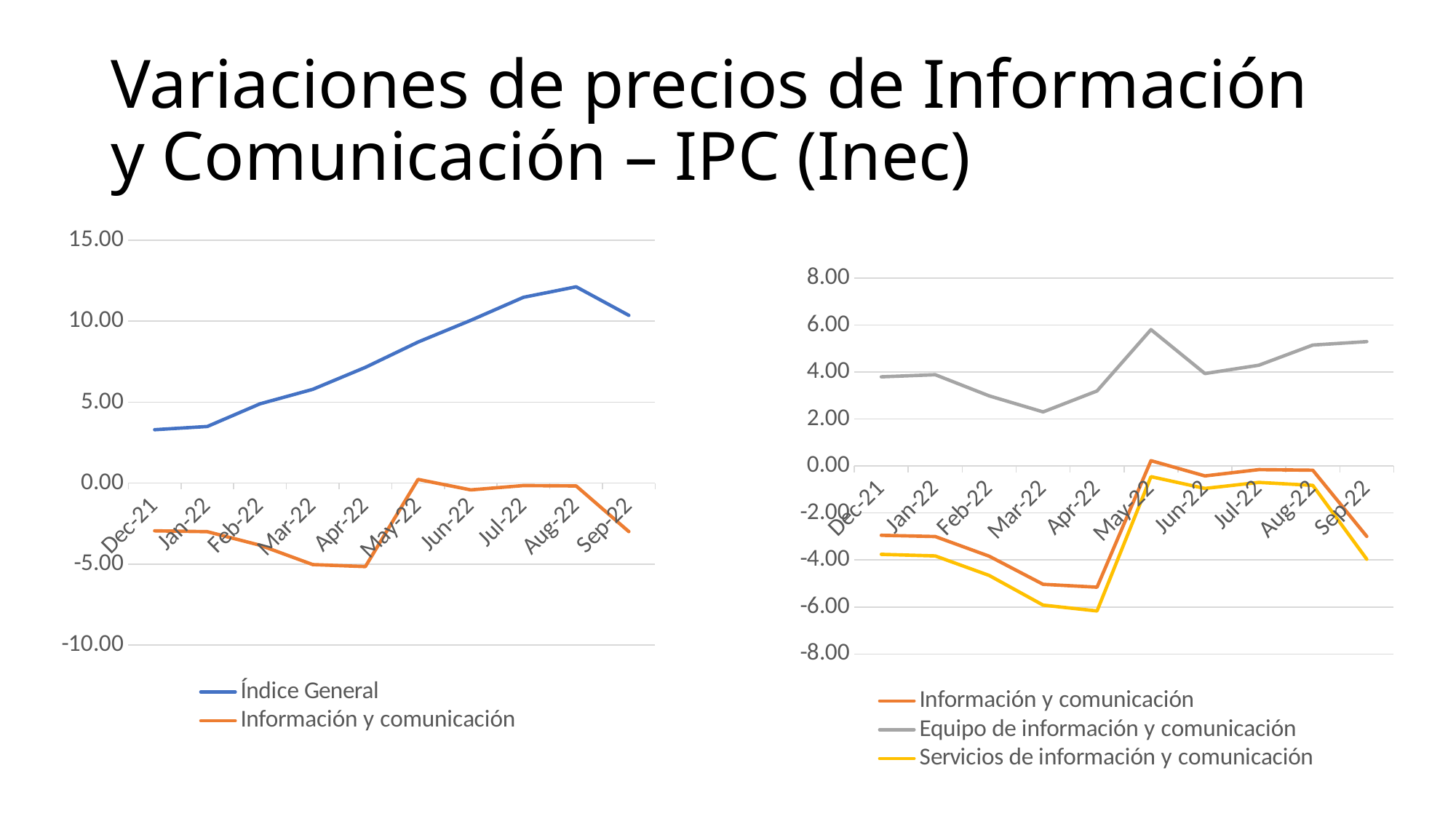
In the left-hand chart, does the Índice General series rise or fall from Dec-21 to Aug-22? rise How many series does the legend of the right-hand chart list? 3 How many months are shown on the x axis of the left-hand chart? 10 In the left-hand chart, in which month is the Información y comunicación series at its lowest? Apr-22 How many series does the legend of the left-hand chart list? 2 What kind of chart is the chart on the left of the slide? line chart In the right-hand chart, in which month is the Servicios de información y comunicación series at its lowest? Apr-22 In the left-hand chart, in which month does the Índice General series reach its highest value? Aug-22 In the left-hand chart, is the value of Índice General in Aug-22 greater or less than 10.00? greater In the left-hand chart, which series has the larger value in Jun-22, Índice General or Información y comunicación? Índice General In the right-hand chart, is the value of Servicios de información y comunicación in Apr-22 greater or less than -4.00? less In the right-hand chart, in which month does the Equipo de información y comunicación series reach its highest value? May-22